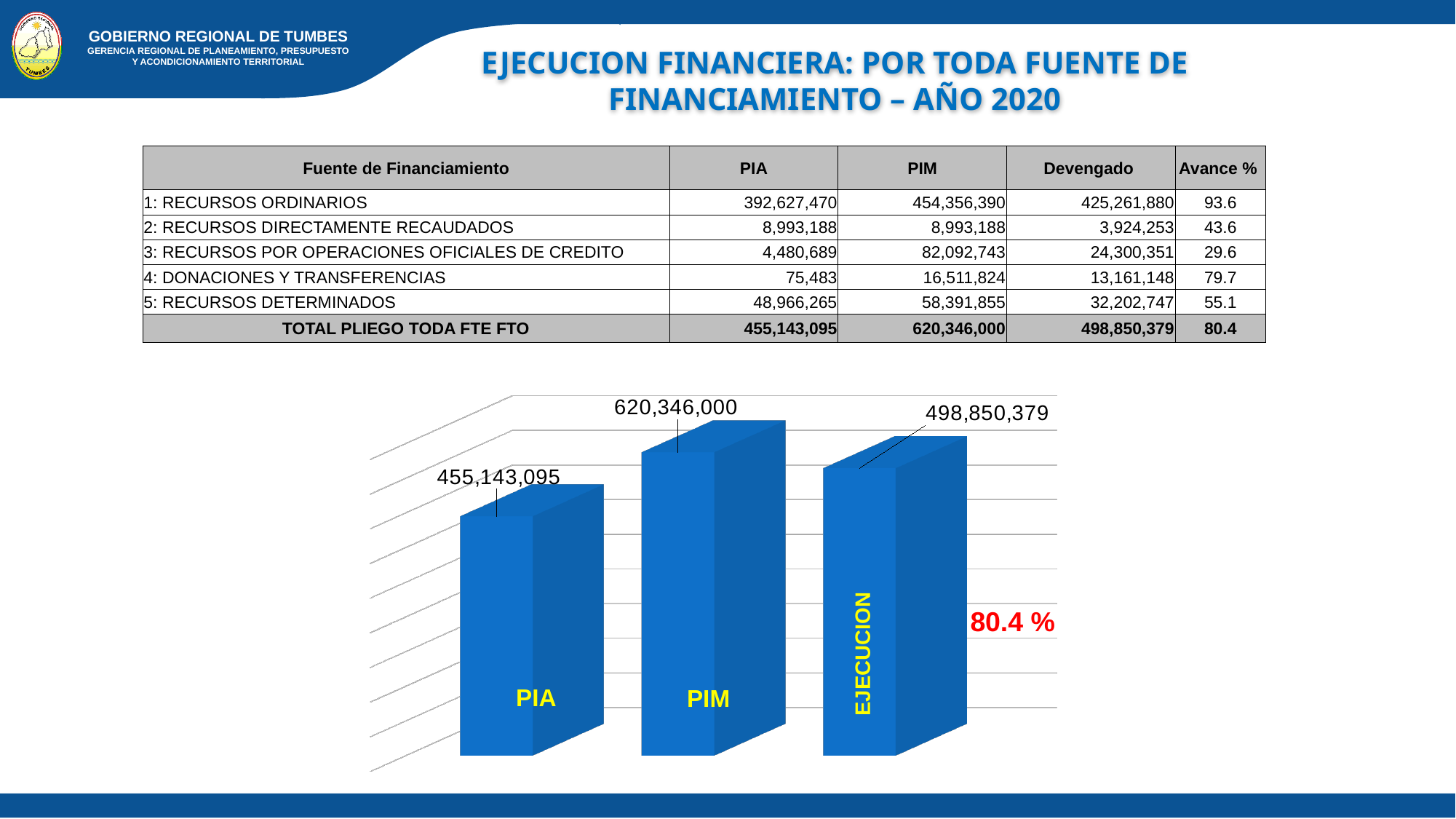
What value is shown for the PIA bar in the chart? 455,143,095 Which bar in the chart has the lowest value? PIA What is the difference between the PIM value and the PIA value in the chart? 165,202,905 Which bar in the chart has the highest value? PIM What value is shown for the PIM bar in the chart? 620,346,000 What is the difference between the PIM value and the EJECUCION value in the chart? 121,495,621 How many bars are plotted in the chart? 3 What value is shown for the EJECUCION bar in the chart? 498,850,379 What kind of chart is shown on the slide? Bar chart Which is larger in the chart, the PIA bar or the EJECUCION bar? EJECUCION What is the difference between the EJECUCION value and the PIA value in the chart? 43,707,284 What percentage is printed in red next to the EJECUCION bar in the chart? 80.4 %